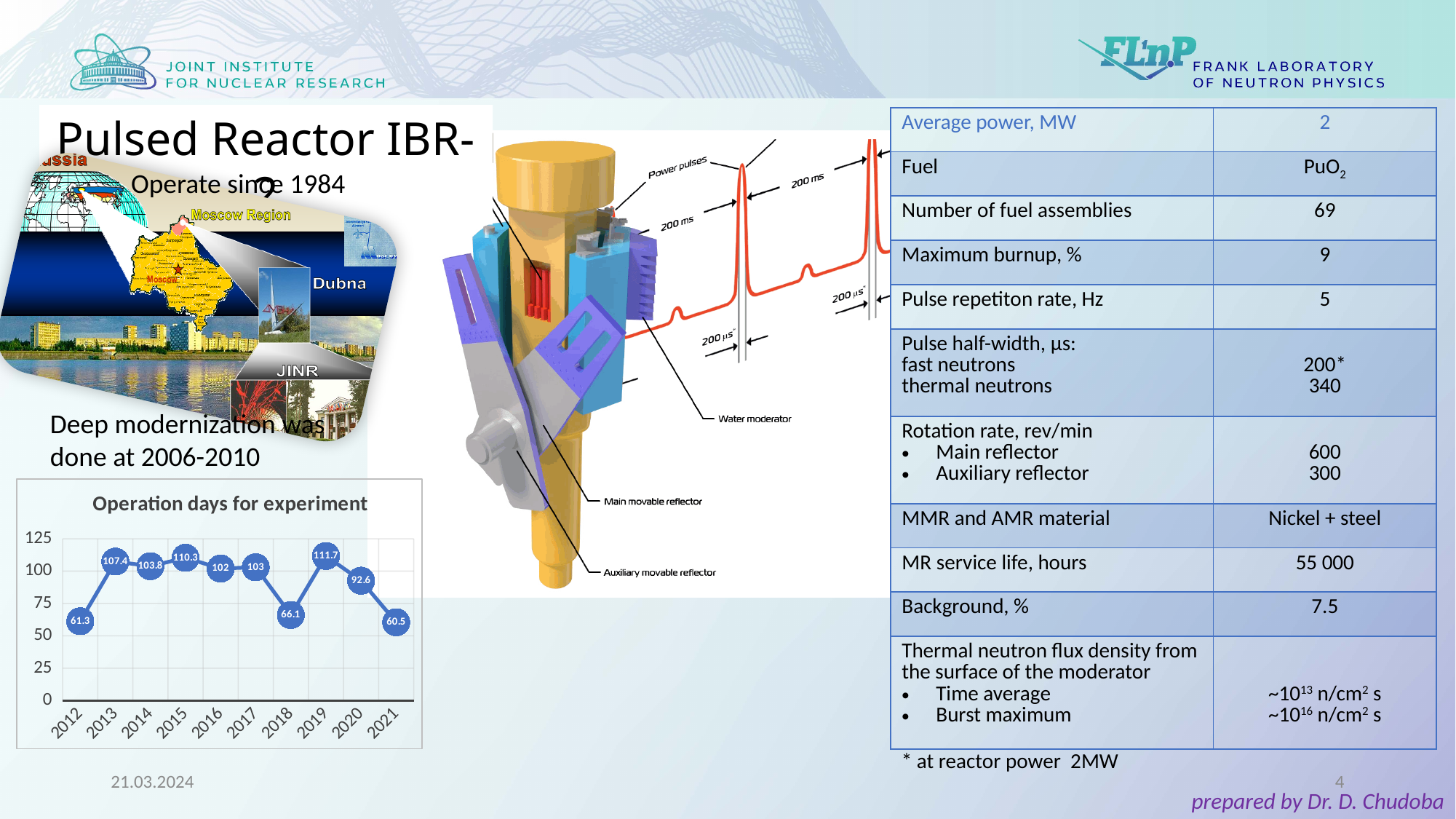
How many years are plotted in the Operation days for experiment chart? 10 What is the value for 2013 in the Operation days for experiment chart? 107.4 In the Operation days for experiment chart, do the values rise or fall from 2019 to 2021? fall What is the title of the chart on the slide? Operation days for experiment What is the value for 2020 in the Operation days for experiment chart? 92.6 Which year has the lowest value in the Operation days for experiment chart? 2021 What is the difference between the values for 2019 and 2018 in the Operation days for experiment chart? 45.6 In the Operation days for experiment chart, which year has the larger value, 2014 or 2017? 2014 What is the value for 2018 in the Operation days for experiment chart? 66.1 In the Operation days for experiment chart, is the value for 2012 greater or less than 75? less What kind of chart is the Operation days for experiment chart? line chart Which year has the highest value in the Operation days for experiment chart? 2019